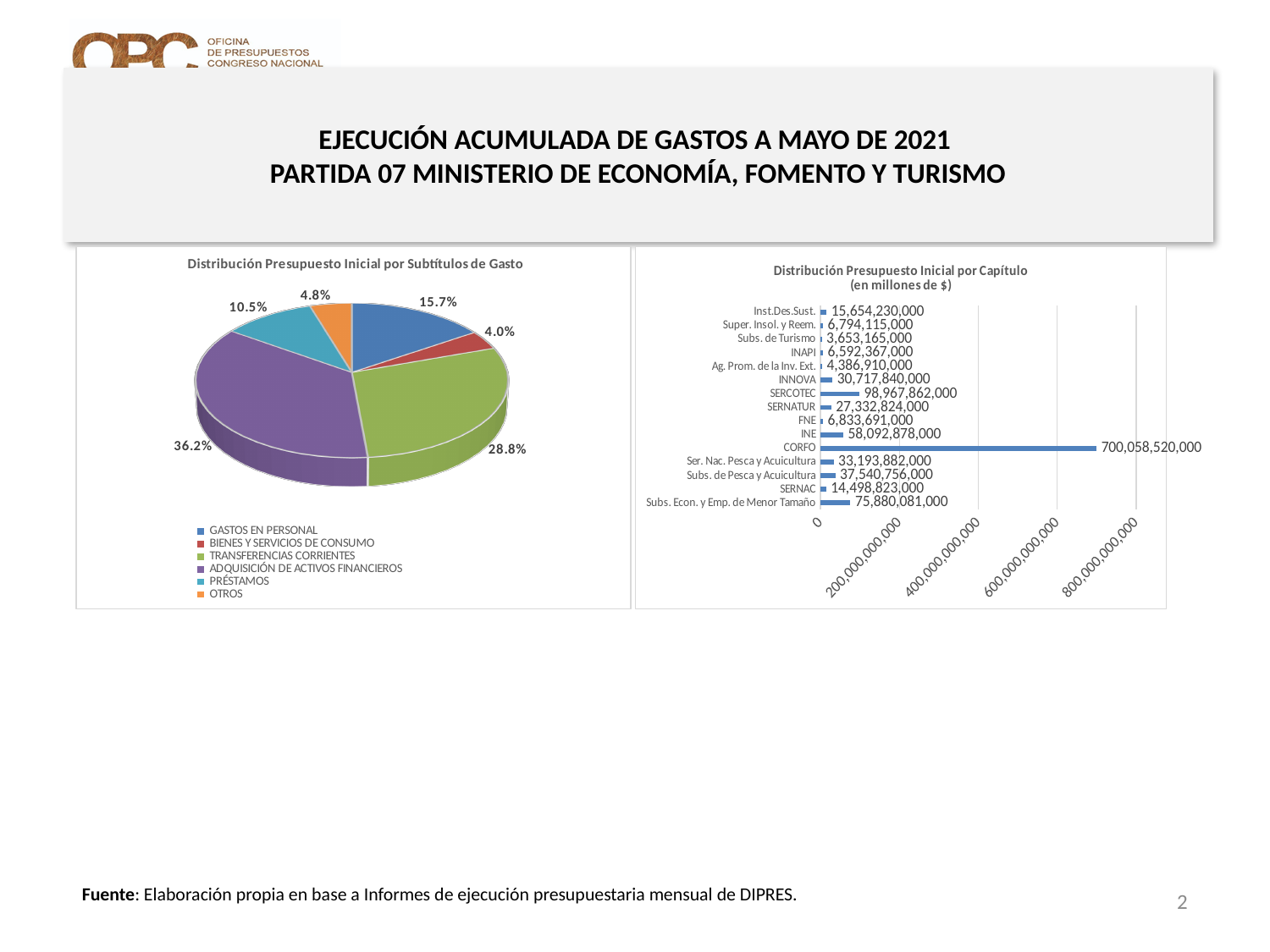
In the pie chart 'Distribución Presupuesto Inicial por Subtítulos de Gasto', what is the difference in percentage points between ADQUISICIÓN DE ACTIVOS FINANCIEROS and TRANSFERENCIAS CORRIENTES? 7.4 In the bar chart 'Distribución Presupuesto Inicial por Capítulo', which is larger, INE or INNOVA? INE In the pie chart 'Distribución Presupuesto Inicial por Subtítulos de Gasto', what share does ADQUISICIÓN DE ACTIVOS FINANCIEROS have? 36.2% In the pie chart 'Distribución Presupuesto Inicial por Subtítulos de Gasto', which category has the smallest share? BIENES Y SERVICIOS DE CONSUMO In the pie chart 'Distribución Presupuesto Inicial por Subtítulos de Gasto', what share does GASTOS EN PERSONAL have? 15.7% In the bar chart 'Distribución Presupuesto Inicial por Capítulo', which capítulo has the lowest value? Subs. de Turismo In the bar chart 'Distribución Presupuesto Inicial por Capítulo', what is the value for CORFO? 700,058,520,000 In the bar chart 'Distribución Presupuesto Inicial por Capítulo', how many capítulos are shown? 15 What kind of chart is 'Distribución Presupuesto Inicial por Capítulo'? Bar chart In the pie chart 'Distribución Presupuesto Inicial por Subtítulos de Gasto', how many categories does the legend list? 6 In the bar chart 'Distribución Presupuesto Inicial por Capítulo', what is the value for SERCOTEC? 98,967,862,000 In the bar chart 'Distribución Presupuesto Inicial por Capítulo', what is the difference between SERCOTEC and INE? 40,874,984,000